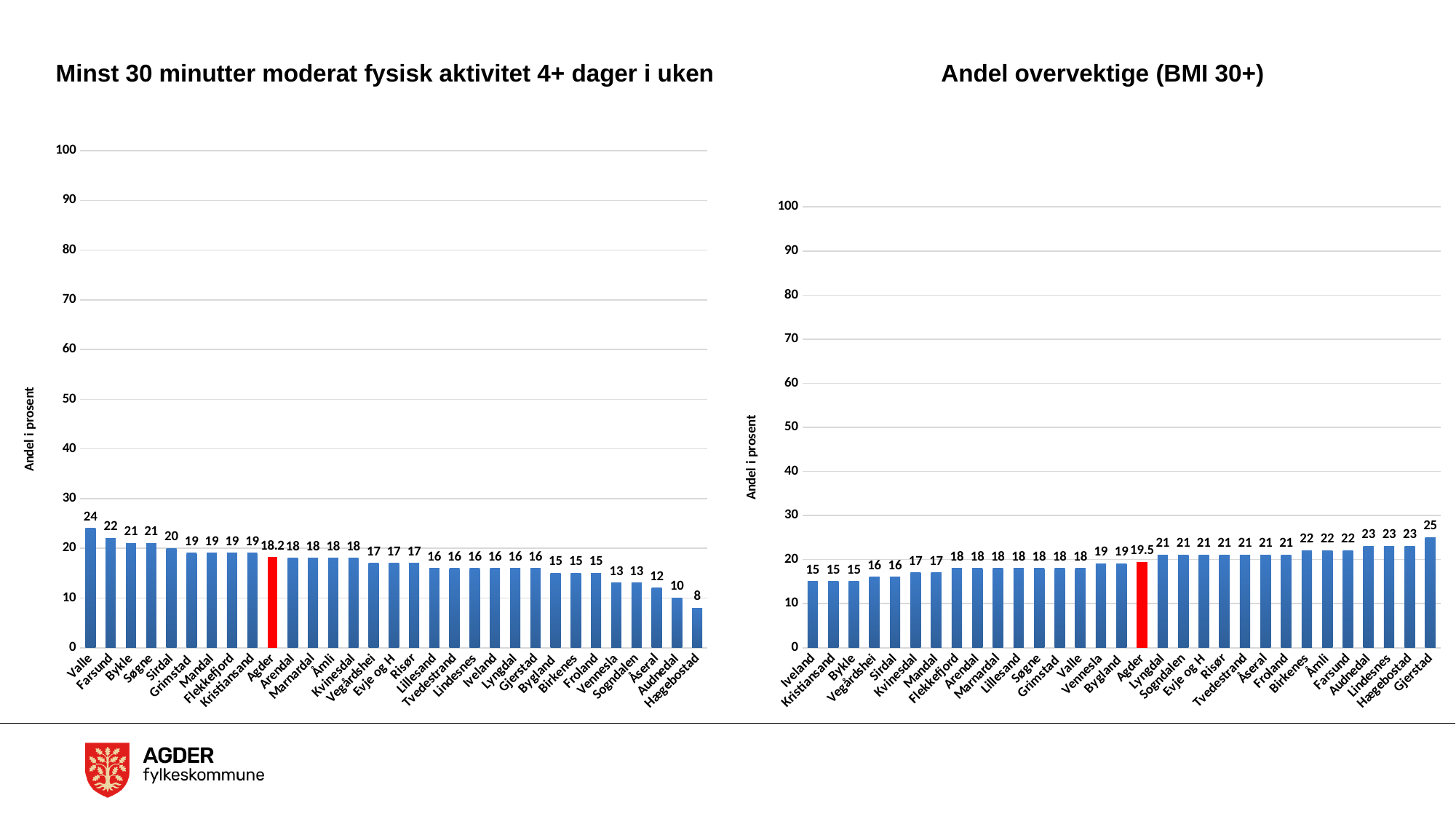
In the chart 'Minst 30 minutter moderat fysisk aktivitet 4+ dager i uken', do the values rise or fall from left to right? fall In the chart 'Andel overvektige (BMI 30+)', what is the value for Gjerstad? 25 In the chart 'Andel overvektige (BMI 30+)', which category has the highest value? Gjerstad In the chart 'Andel overvektige (BMI 30+)', how many categories are shown on the x axis? 31 In the chart 'Andel overvektige (BMI 30+)', which is larger, the value for Iveland or the value for Audnedal? Audnedal In the chart 'Andel overvektige (BMI 30+)', what is the value for Agder? 19.5 In the chart 'Minst 30 minutter moderat fysisk aktivitet 4+ dager i uken', what is the difference between Valle and Hægebostad? 16 What kind of chart is 'Andel overvektige (BMI 30+)'? bar chart In the chart 'Minst 30 minutter moderat fysisk aktivitet 4+ dager i uken', what is the value for Valle? 24 In the chart 'Minst 30 minutter moderat fysisk aktivitet 4+ dager i uken', which category has the lowest value? Hægebostad In the chart 'Minst 30 minutter moderat fysisk aktivitet 4+ dager i uken', what is the value for Agder? 18.2 In the chart 'Minst 30 minutter moderat fysisk aktivitet 4+ dager i uken', which bar is coloured red? Agder